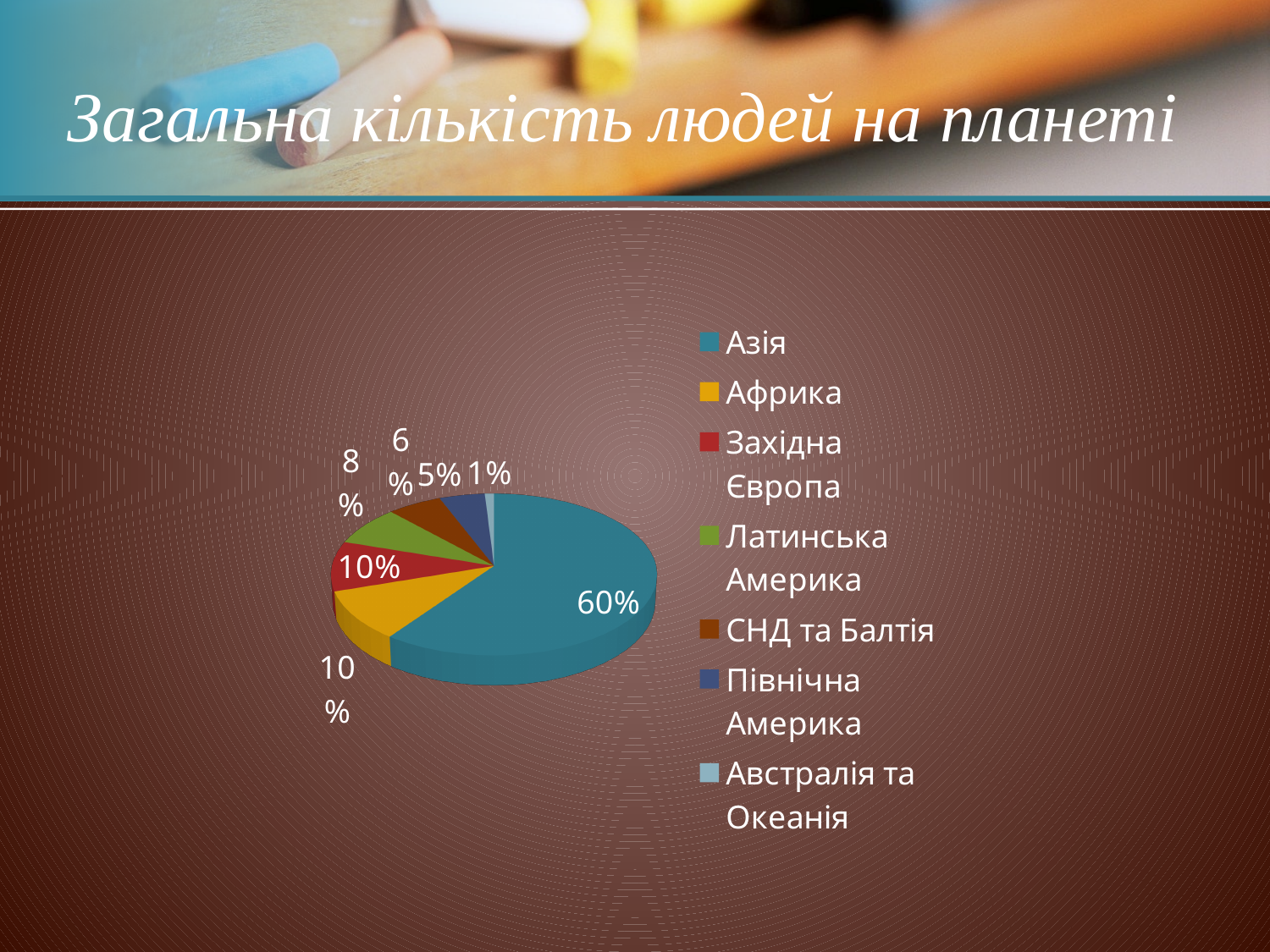
How many categories does the legend of the pie chart list? 7 What is the difference between the shares of Азія and Латинська Америка? 52% Which category has the smallest slice of the pie? Австралія та Океанія What share of the pie does Азія have? 60% What share of the pie does СНД та Балтія have? 6% What share of the pie does Північна Америка have? 5% Which is larger, the share of Північна Америка or the share of СНД та Балтія? СНД та Балтія Which category has the largest slice of the pie? Азія What share of the pie does Австралія та Океанія have? 1% What share of the pie does Латинська Америка have? 8% What kind of chart is shown on the slide? pie chart What is the title of the chart on the slide? Загальна кількість людей на планеті